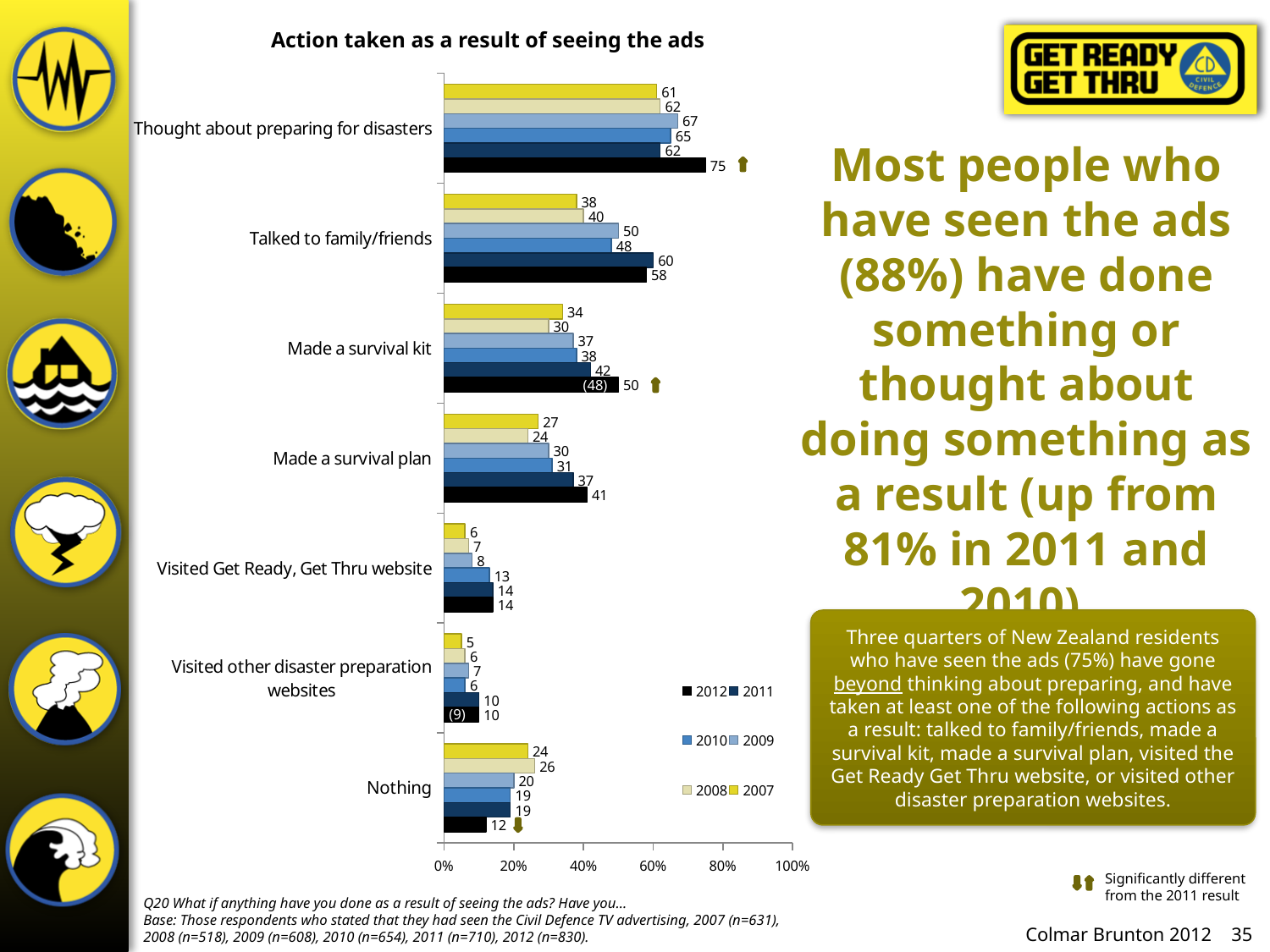
Which action category has the highest 2012 value? Thought about preparing for disasters Is the 2012 value for 'Thought about preparing for disasters' greater or less than 60%? greater Which action category has the lowest 2012 value? Visited other disaster preparation websites How many action categories are shown on the chart? 7 What is the 2012 value for 'Nothing'? 12 What is the 2011 value for 'Talked to family/friends'? 60 For 'Made a survival kit', which is larger: the 2012 value or the 2007 value? 2012 What is the difference between the 2012 and 2011 values for 'Made a survival plan'? 4 What is the title of the chart? Action taken as a result of seeing the ads How many series does the chart legend list? 6 What is the 2012 value for 'Thought about preparing for disasters'? 75 What kind of chart is shown on the slide? bar chart